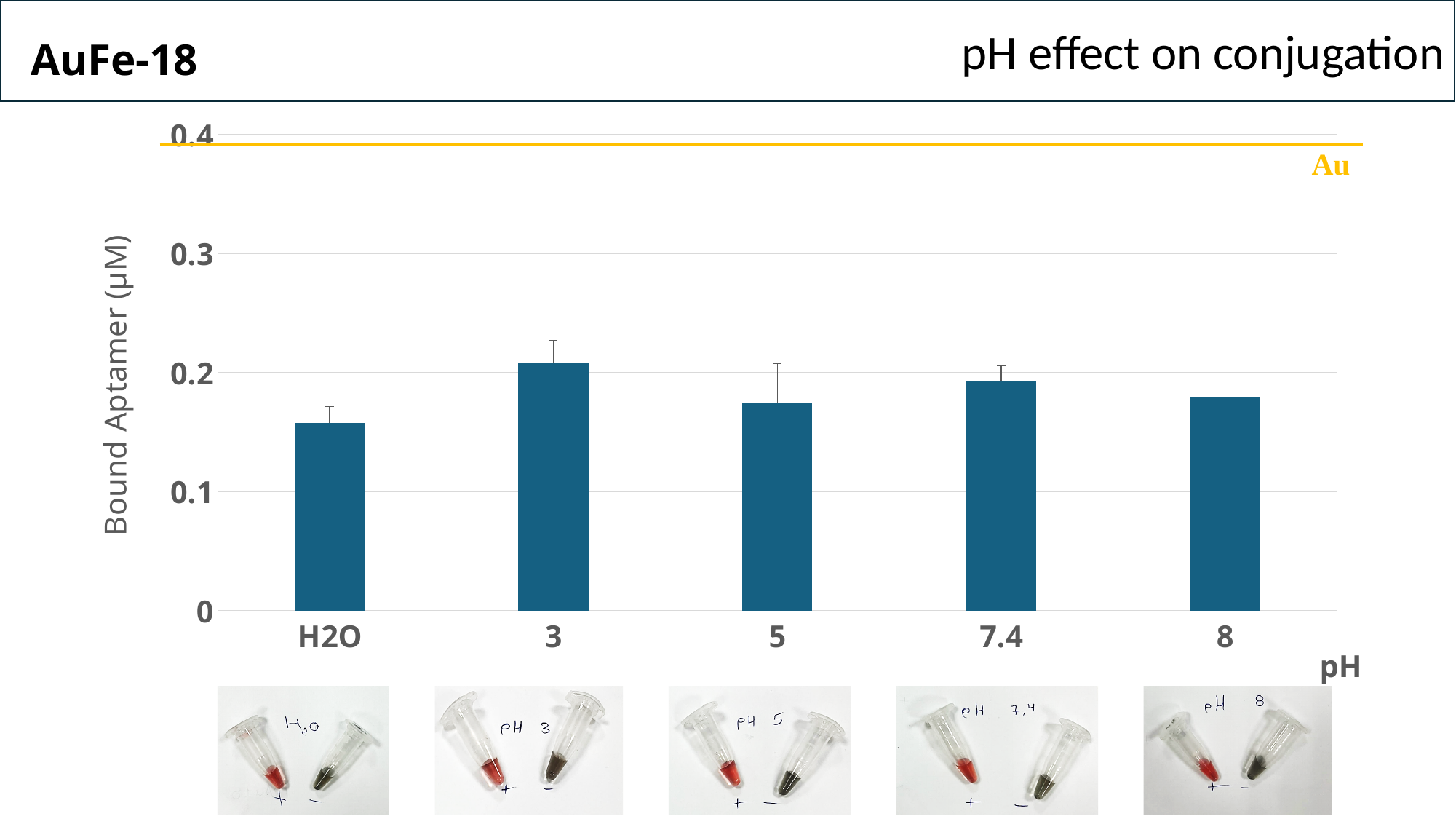
What kind of chart is shown on the slide? bar chart How many categories are plotted on the x axis of the chart? 5 Which has a larger bound aptamer value, pH 5 or pH 7.4? 7.4 Which has a larger bound aptamer value, H2O or pH 3? 3 Which category has the highest bound aptamer value? 3 Is the bound aptamer value for pH 3 greater or less than 0.2? greater What is the label of the y axis of the chart? Bound Aptamer (µM) Which category has the lowest bound aptamer value? H2O What label is attached to the yellow horizontal line near the top of the chart? Au Is the bound aptamer value for pH 5 greater or less than 0.1? greater Is the bound aptamer value for pH 8 greater or less than 0.2? less